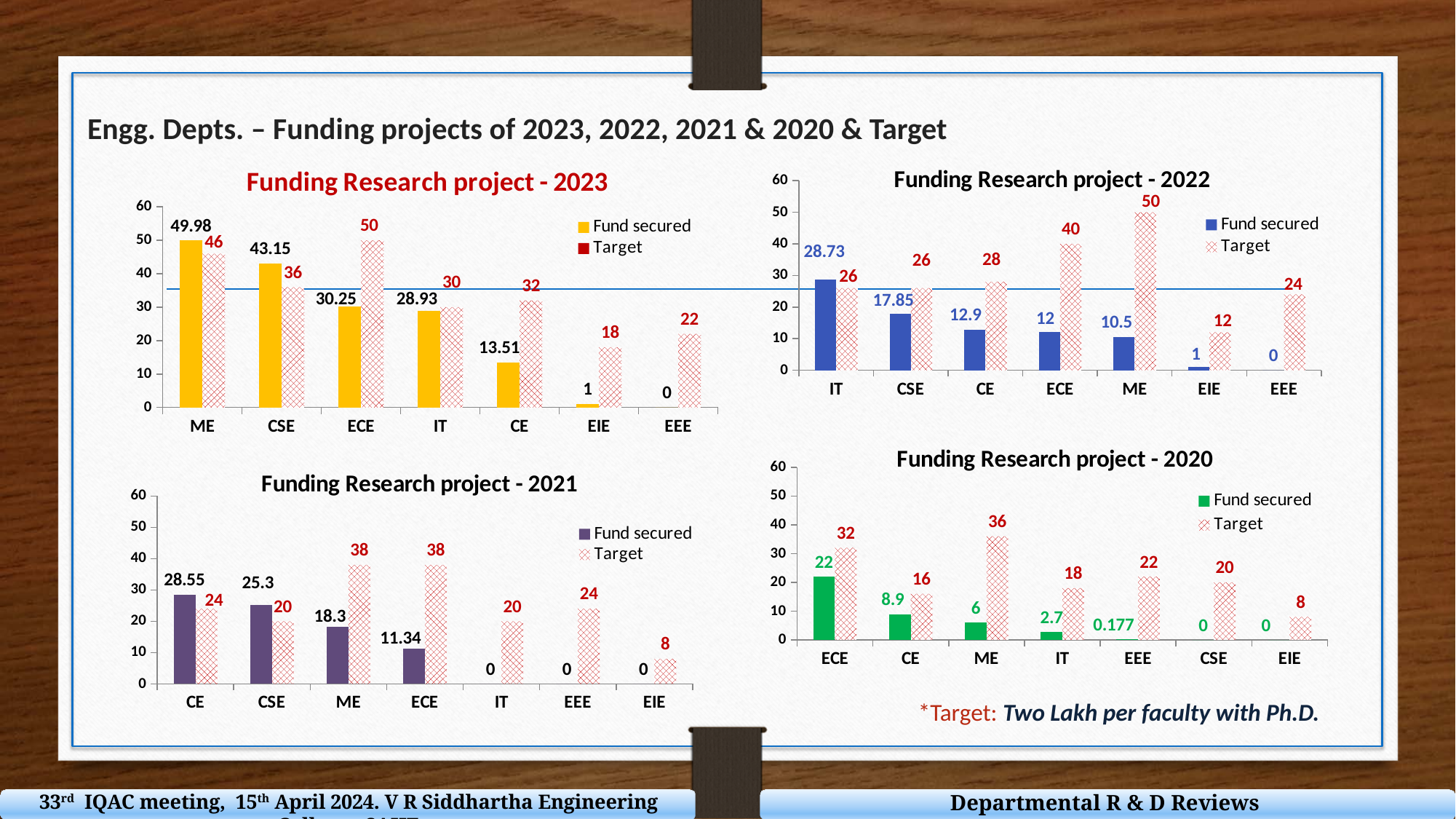
In the 'Funding Research project - 2020' chart, which department has the lowest Target value? EIE In the 'Funding Research project - 2022' chart, what is the Target value for ME? 50 In the 'Funding Research project - 2022' chart, what is the difference between the Target and Fund secured values for ECE? 28 In the 'Funding Research project - 2021' chart, which department has the highest Fund secured value? CE How many departments are shown on the x axis of the 'Funding Research project - 2020' chart? 7 In the 'Funding Research project - 2022' chart, do the Fund secured values rise or fall from IT to EEE along the x axis? fall In the 'Funding Research project - 2021' chart, is the Fund secured value for CSE larger or smaller than its Target value? larger In the 'Funding Research project - 2020' chart, what is the Fund secured value for EEE? 0.177 What type of chart is the 'Funding Research project - 2021' chart? bar chart In the 'Funding Research project - 2023' chart, what is the Fund secured value for ME? 49.98 How many series does the legend of the 'Funding Research project - 2023' chart list? 2 In the 'Funding Research project - 2023' chart, which department has the highest Target value? ECE